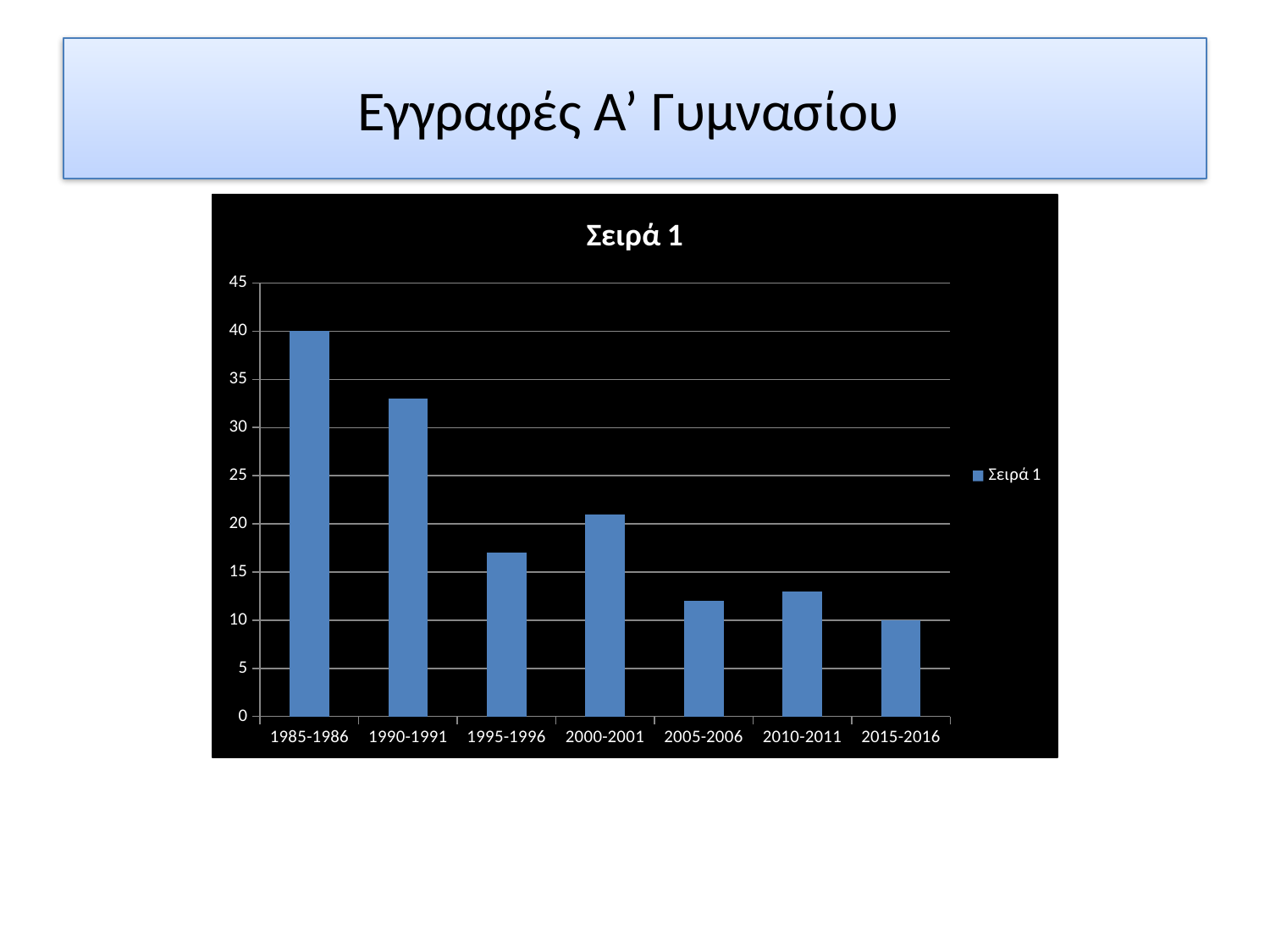
How many series does the legend list? 1 Do the values generally rise or fall from 1985-1986 to 2015-2016? Fall Is the value for 2000-2001 greater or less than 25? less What is the value for 1985-1986? 40 How many categories are shown on the x axis of the chart? 7 Which is larger, the value for 1990-1991 or the value for 2000-2001? 1990-1991 What is the difference between the values for 1985-1986 and 2015-2016? 30 What type of chart is shown on the slide? Bar chart What is the value for 2015-2016? 10 What is the title of the chart? Σειρά 1 Is the value for 1990-1991 greater or less than 30? greater Which category has the highest value? 1985-1986